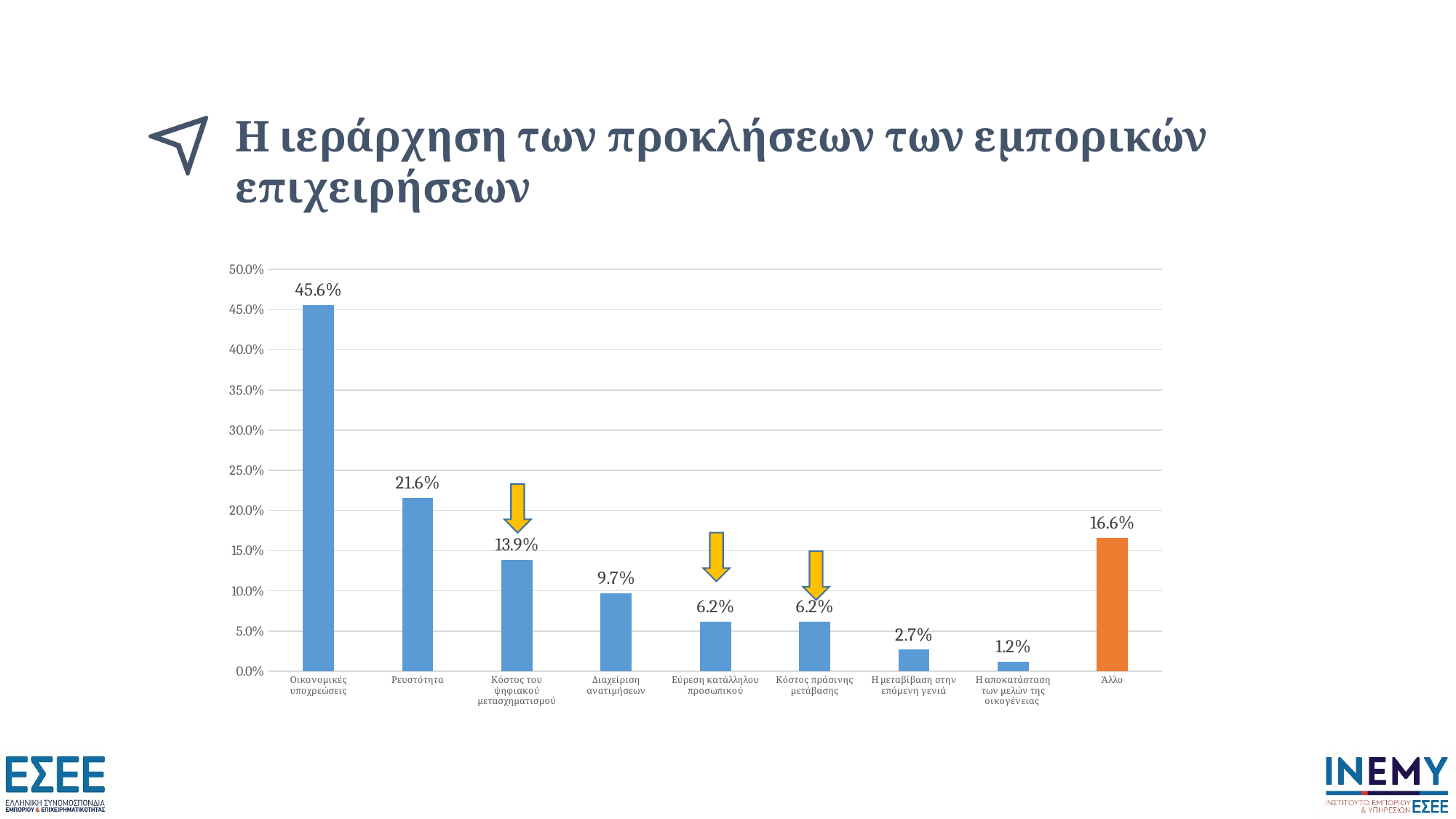
What is the difference between the values for Οικονομικές υποχρεώσεις and Ρευστότητα? 24.0% What is the value for Κόστος του ψηφιακού μετασχηματισμού? 13.9% Which bar is coloured orange rather than blue? Άλλο How many categories are shown on the x axis? 9 Which category has the highest value? Οικονομικές υποχρεώσεις Is the value for Ρευστότητα greater or less than 20.0%? greater What is the value for Άλλο? 16.6% What is the value for Ρευστότητα? 21.6% Which is larger, the value for Διαχείριση ανατιμήσεων or the value for Άλλο? Άλλο What is the value for Οικονομικές υποχρεώσεις? 45.6% Which category has the lowest value? Η αποκατάσταση των μελών της οικογένειας What kind of chart is shown on the slide? bar chart